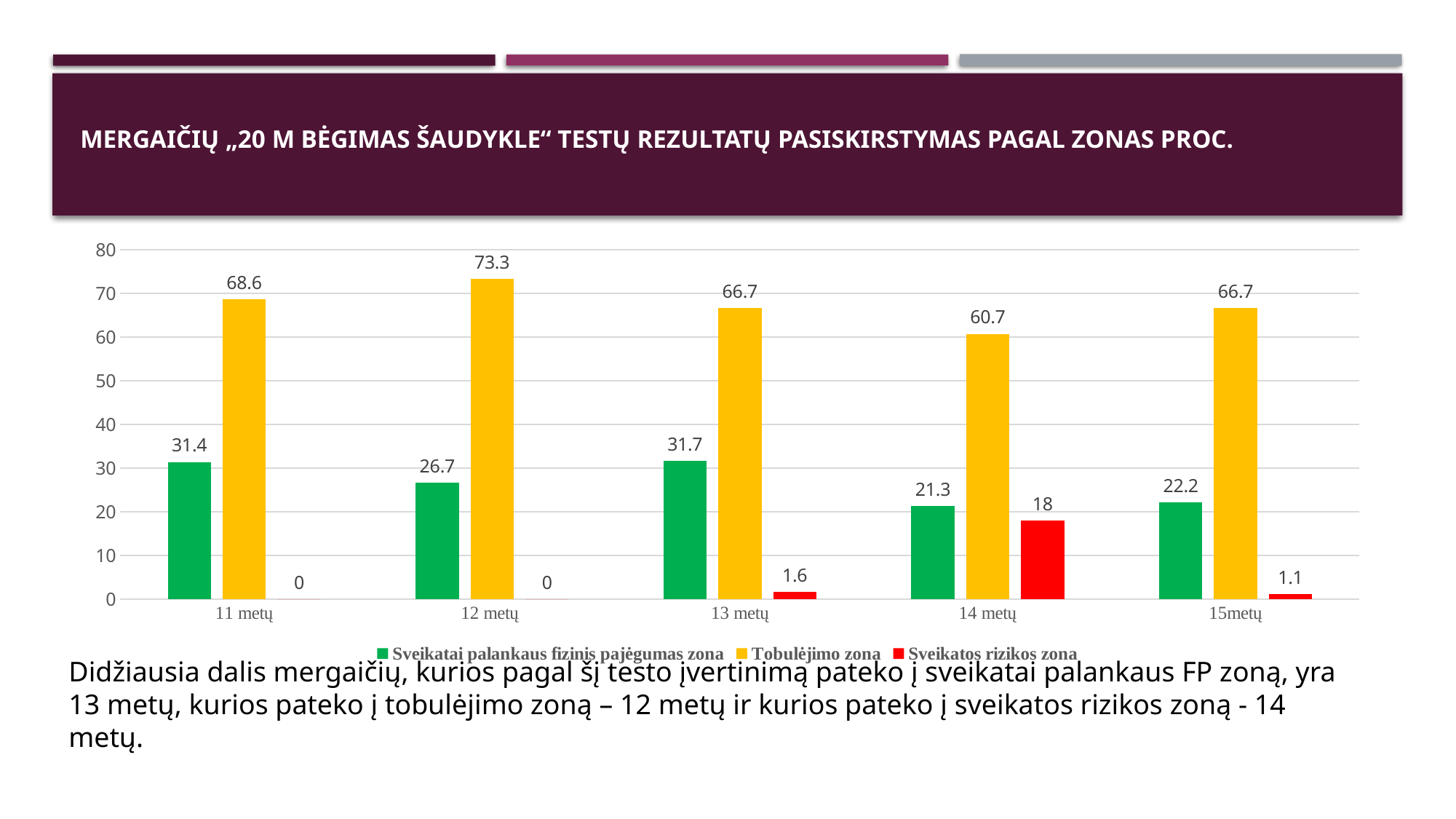
What is the difference between the Tobulėjimo zona values for 12 metų and 14 metų? 12.6 What kind of chart is shown on the slide? bar chart What colour represents the Sveikatos rizikos zona series? red How many series does the legend list? 3 Is the Tobulėjimo zona value for 14 metų greater or less than 70? less How many age groups are shown on the x axis? 5 What is the value of the Sveikatai palankaus fizinis pajėgumas zona series for 13 metų? 31.7 What is the value of the Tobulėjimo zona series for 12 metų? 73.3 Which age group has the lowest value in the Sveikatai palankaus fizinis pajėgumas zona series? 14 metų Which is larger: the Sveikatai palankaus fizinis pajėgumas zona value for 11 metų or for 15metų? 11 metų What is the value of the Sveikatos rizikos zona series for 14 metų? 18 Which age group has the highest value in the Tobulėjimo zona series? 12 metų